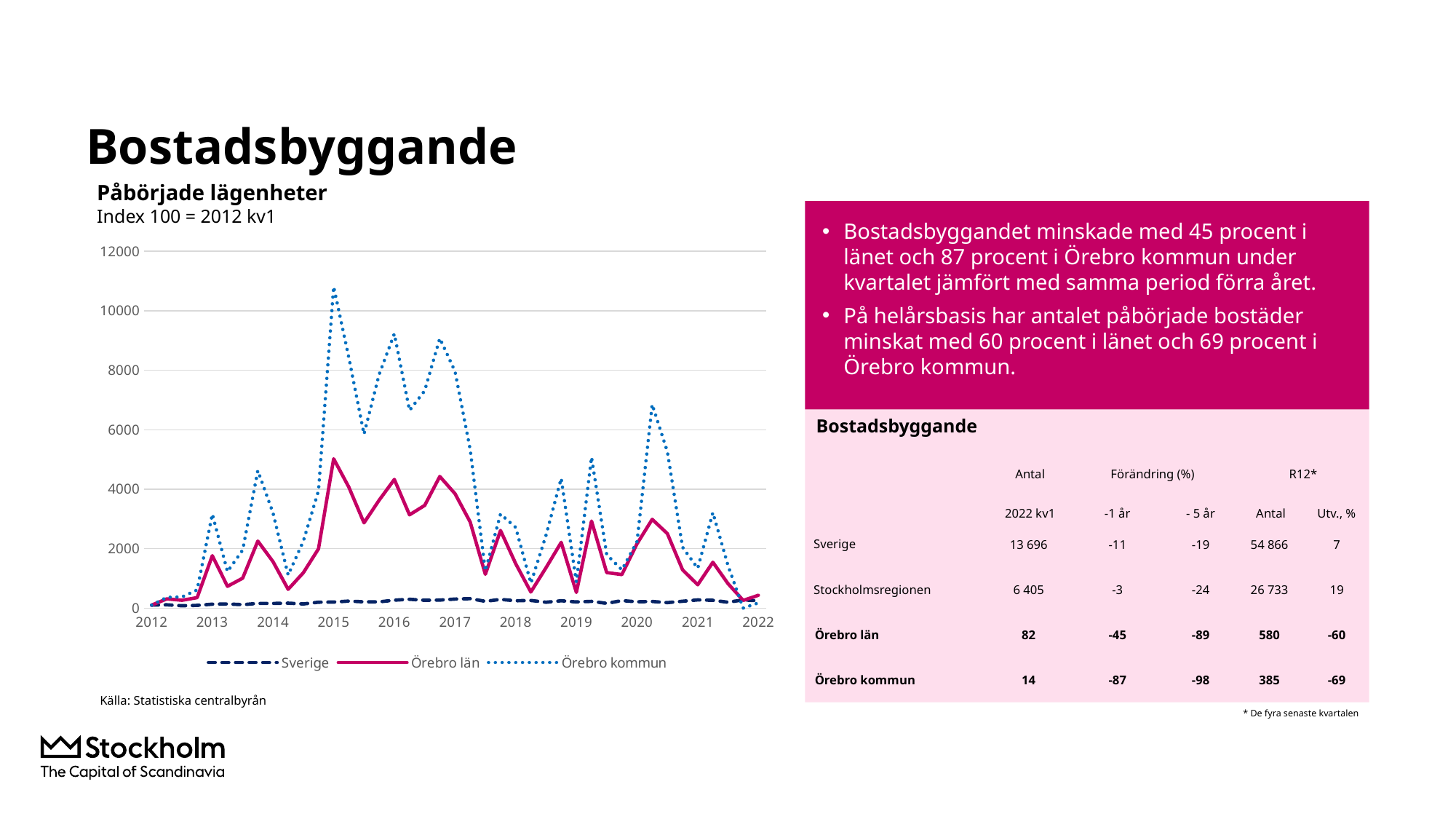
How many year labels are shown on the x axis of the chart? 11 Is the peak value for Örebro kommun in 2020 greater or less than 6000? greater How many series does the chart legend list? 3 What kind of chart is shown on the slide? line chart Is the peak value for Örebro kommun in 2015 greater or less than 10000? greater What is the title of the chart? Påbörjade lägenheter Which series has the larger value at its 2015 peak, Örebro län or Örebro kommun? Örebro kommun Is the peak value for Örebro län in 2015 greater or less than 4000? greater Which series reaches the highest peak in the chart? Örebro kommun Which series is shown with a dotted line in the chart? Örebro kommun